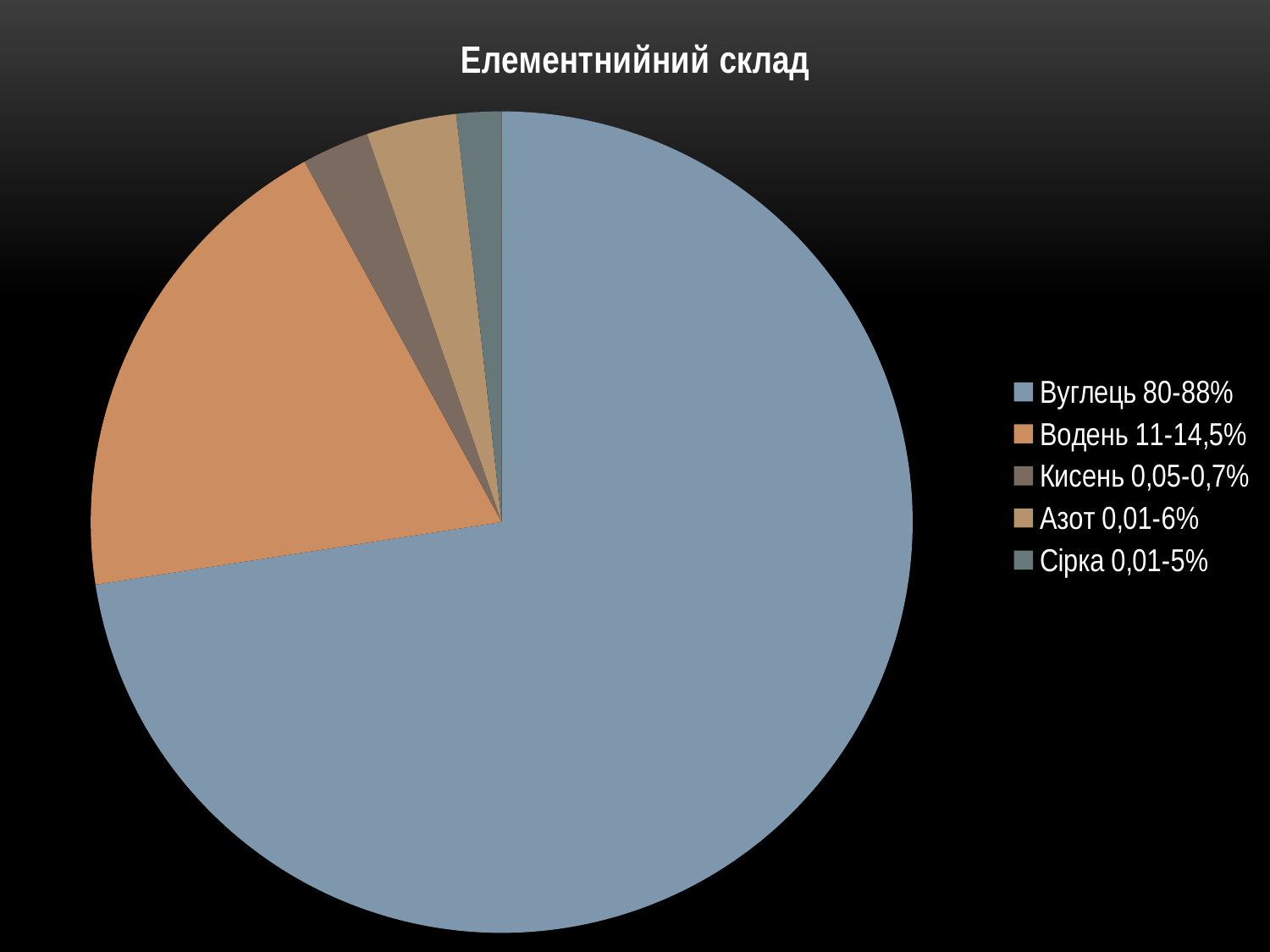
Which category is shown in orange in the pie chart? Водень Which slice is larger, Вуглець or Водень? Вуглець What percentage range does the legend give for Кисень? 0,05-0,7% Which category has the largest slice of the pie? Вуглець What percentage range does the legend give for Вуглець? 80-88% Which category has the smallest slice of the pie? Сірка Which slice is larger, Водень or Азот? Водень What kind of chart is shown on the slide? pie chart What percentage range does the legend give for Сірка? 0,01-5% How many categories (slices) does the pie chart have? 5 What percentage range does the legend give for Водень? 11-14,5% What is the title of the chart? Елементнийний склад